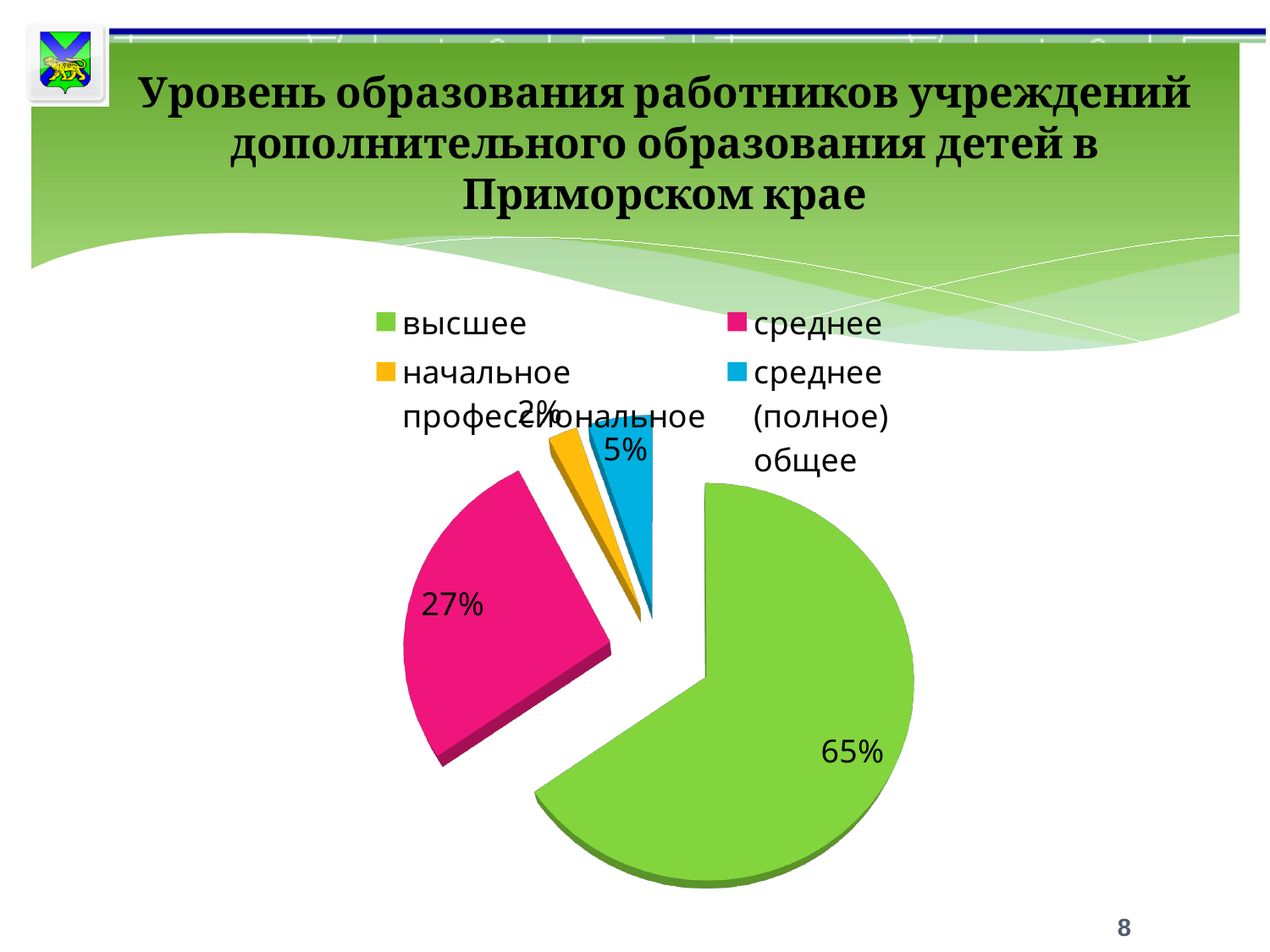
Which category has the largest slice of the pie? высшее How many entries does the legend list? 4 How many slices does the pie chart have? 4 What share of the pie does the "начальное профессиональное" slice have? 2% Which category has the smallest slice of the pie? начальное профессиональное What kind of chart is shown on the slide? pie chart Which slice is larger, "среднее (полное) общее" or "начальное профессиональное"? среднее (полное) общее What share of the pie does the "среднее" slice have? 27% What is the difference in percentage points between the "высшее" and "среднее" slices? 38 What share of the pie does the "среднее (полное) общее" slice have? 5% What colour is the "среднее" slice? pink What share of the pie does the "высшее" slice have? 65%